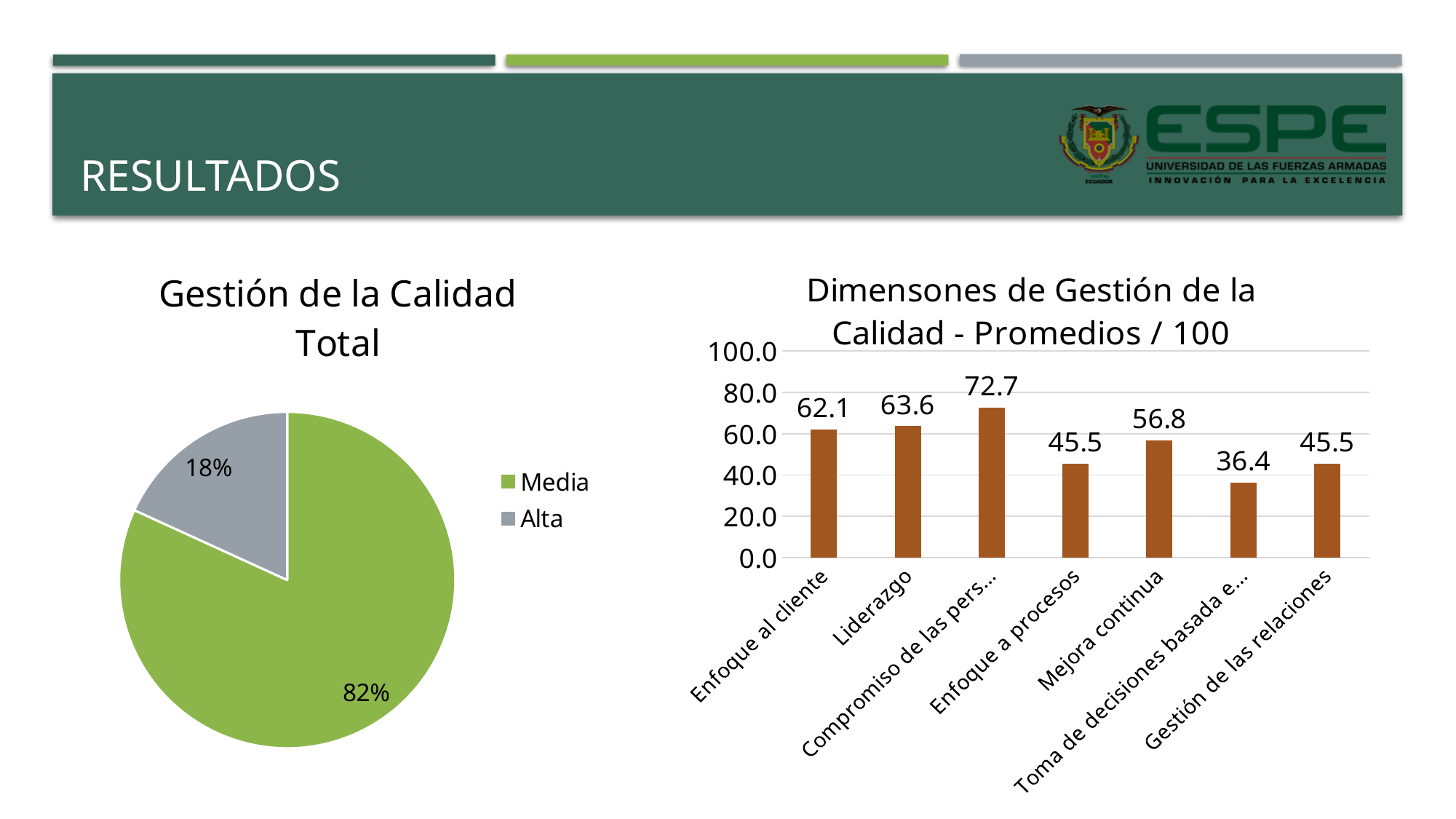
In the 'Dimensones de Gestión de la Calidad - Promedios / 100' chart, which category has the highest value? Compromiso de las pers... In the 'Dimensones de Gestión de la Calidad - Promedios / 100' chart, what is the difference between 'Enfoque al cliente' and 'Enfoque a procesos'? 16.6 In the 'Gestión de la Calidad Total' pie chart, how many entries does the legend list? 2 How many categories are shown in the 'Dimensones de Gestión de la Calidad - Promedios / 100' chart? 7 What kind of chart is 'Dimensones de Gestión de la Calidad - Promedios / 100'? Bar chart In the 'Gestión de la Calidad Total' pie chart, what share does 'Alta' have? 18% In the 'Dimensones de Gestión de la Calidad - Promedios / 100' chart, which is larger: 'Liderazgo' or 'Mejora continua'? Liderazgo In the 'Dimensones de Gestión de la Calidad - Promedios / 100' chart, what is the value for 'Mejora continua'? 56.8 What kind of chart is 'Gestión de la Calidad Total'? Pie chart In the 'Dimensones de Gestión de la Calidad - Promedios / 100' chart, which category has the lowest value? Toma de decisiones basada e... In the 'Gestión de la Calidad Total' pie chart, what share does 'Media' have? 82% In the 'Dimensones de Gestión de la Calidad - Promedios / 100' chart, what is the value for 'Liderazgo'? 63.6